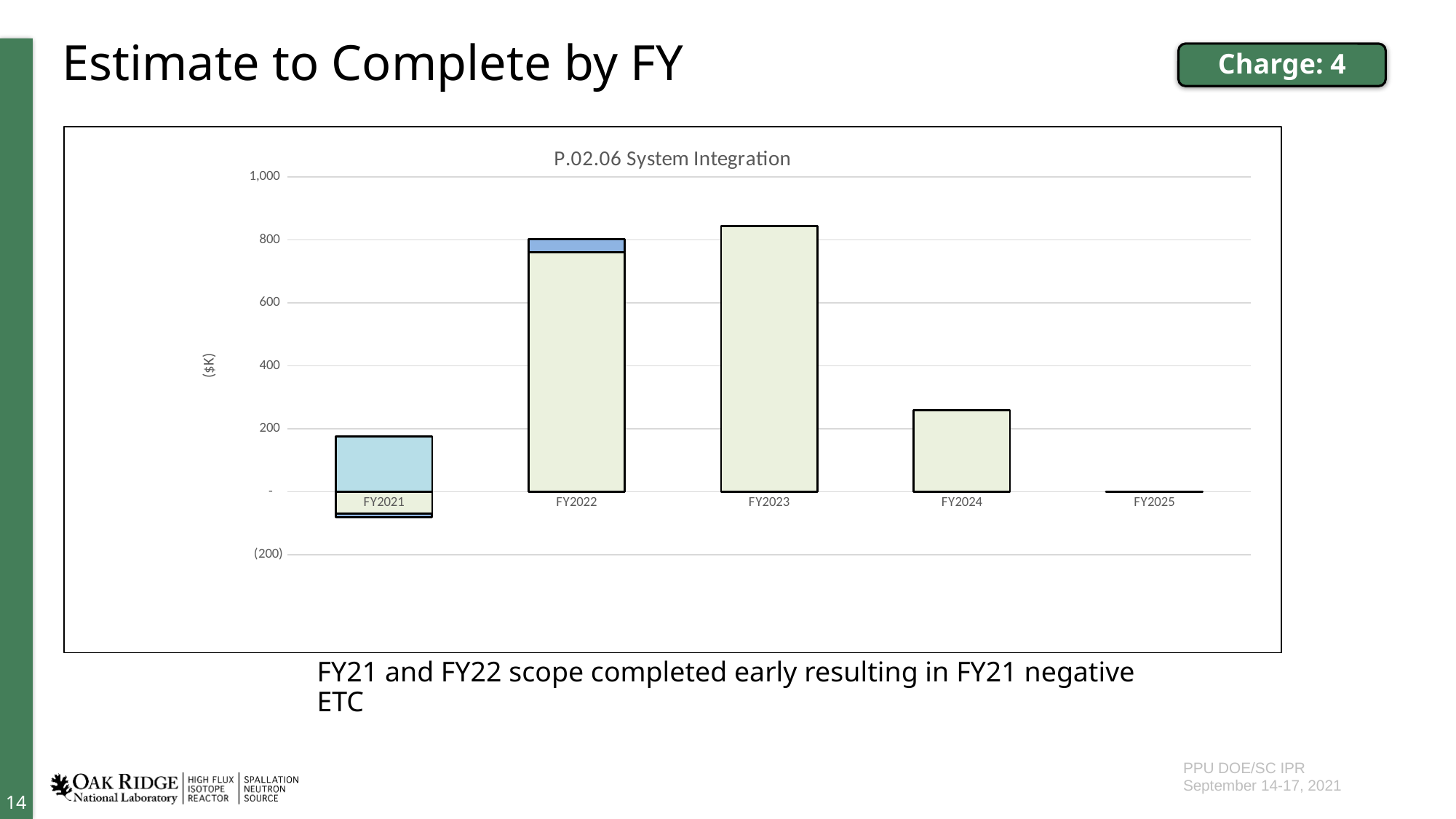
Is the value for FY2023 greater or less than 800? greater What is the title of the chart? P.02.06 System Integration Which has the larger bar, FY2022 or FY2024? FY2022 How many fiscal years are shown on the x axis of the chart? 5 Which fiscal year is the only one with a bar extending below zero? FY2021 What kind of chart is shown on the slide? bar chart Is the total value for FY2022 greater or less than 600? greater Which fiscal year has the tallest bar in the chart? FY2023 Is the value for FY2024 greater or less than 200? greater Which fiscal year has the smallest bar in the chart? FY2025 What unit is shown on the vertical axis label of the chart? ($K)